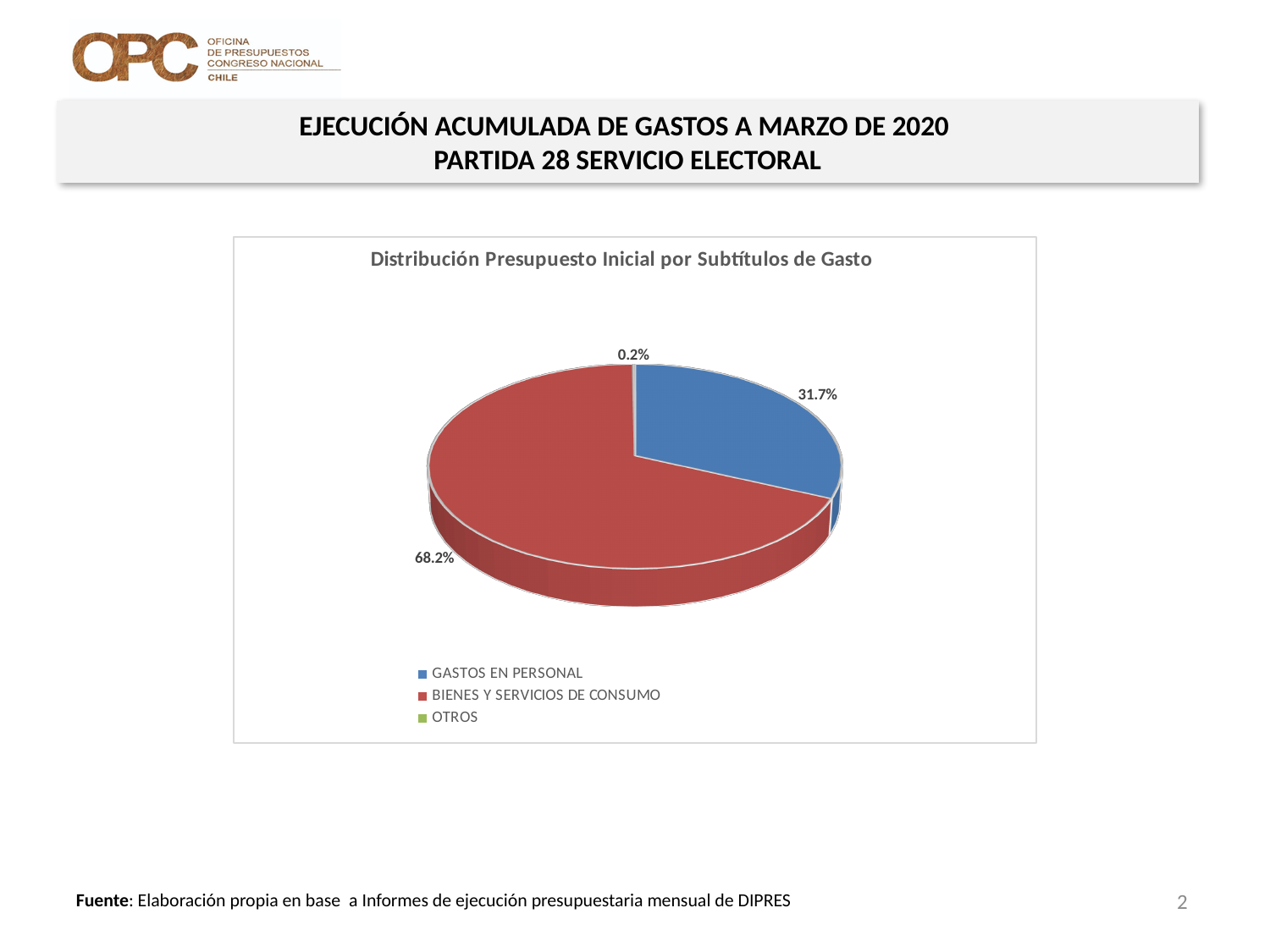
How many categories does the legend list? 3 What share of the pie does BIENES Y SERVICIOS DE CONSUMO represent? 68.2% What is the difference in percentage points between GASTOS EN PERSONAL and OTROS? 31.5 Which category has the largest share of the pie? BIENES Y SERVICIOS DE CONSUMO Which is larger, the share for GASTOS EN PERSONAL or the share for OTROS? GASTOS EN PERSONAL What is the difference in percentage points between BIENES Y SERVICIOS DE CONSUMO and GASTOS EN PERSONAL? 36.5 What share of the pie does OTROS represent? 0.2% Which category has the smallest share of the pie? OTROS What colour is the slice for GASTOS EN PERSONAL? blue What share of the pie does GASTOS EN PERSONAL represent? 31.7% What is the title of the chart? Distribución Presupuesto Inicial por Subtítulos de Gasto What kind of chart is shown on the slide? pie chart